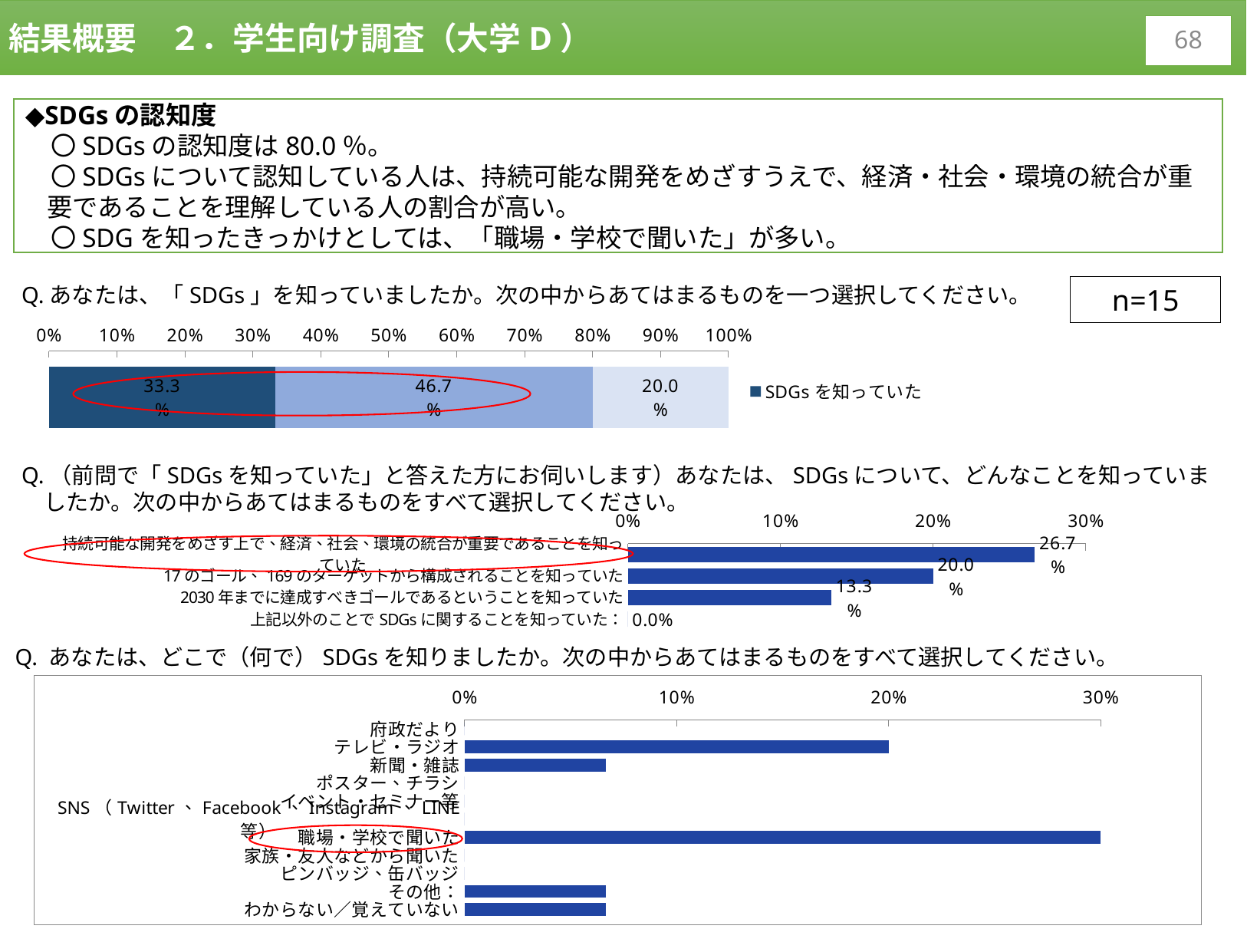
What kind of chart is the bottom chart (Q. どこで（何で）SDGsを知りましたか)? bar chart In the top stacked bar chart (Q. あなたは、「SDGs」を知っていましたか), what is the value of the rightmost (lightest) segment? 20.0% In the top stacked bar chart (Q. あなたは、「SDGs」を知っていましたか), what is the value of the darkest (leftmost) segment? 33.3% In the top stacked bar chart (Q. あなたは、「SDGs」を知っていましたか), what is the value of the middle segment? 46.7% In the bottom bar chart (Q. どこで（何で）SDGsを知りましたか), which category has the highest value? 職場・学校で聞いた In the middle bar chart (Q. SDGsについて、どんなことを知っていましたか), what is the value for 「2030年までに達成すべきゴールであるということを知っていた」? 13.3% In the bottom bar chart (Q. どこで（何で）SDGsを知りましたか), which is larger, the value for 「テレビ・ラジオ」 or the value for 「新聞・雑誌」? テレビ・ラジオ In the bottom bar chart (Q. どこで（何で）SDGsを知りましたか), is the value for 「テレビ・ラジオ」 greater or less than 30%? less In the middle bar chart (Q. SDGsについて、どんなことを知っていましたか), how many categories are plotted? 4 In the middle bar chart (Q. SDGsについて、どんなことを知っていましたか), what is the value for 「持続可能な開発をめざす上で、経済、社会、環境の統合が重要であることを知っていた」? 26.7% In the middle bar chart (Q. SDGsについて、どんなことを知っていましたか), which category has the lowest value? 上記以外のことでSDGsに関することを知っていた In the top stacked bar chart, what is the difference between the middle segment (46.7%) and the leftmost segment (33.3%)? 13.4%